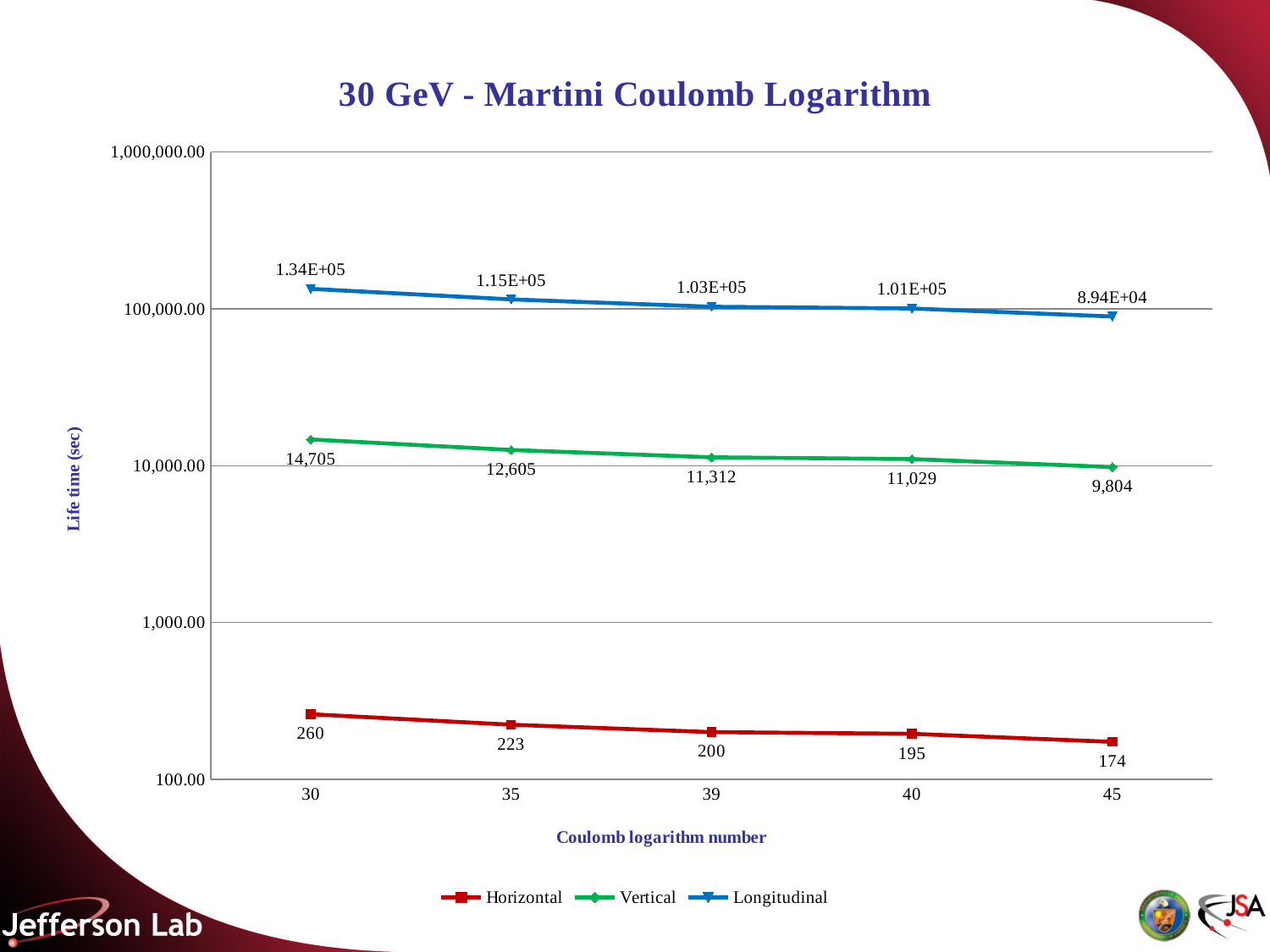
At which Coulomb logarithm number is the Horizontal life time lowest? 45 At which Coulomb logarithm number is the Vertical life time highest? 30 Which is larger, the Horizontal life time at 35 or at 40? 35 What is the Longitudinal life time at Coulomb logarithm number 45? 8.94E+04 What is the difference between the Vertical life time at 30 and at 35? 2,100 What is the Vertical life time at Coulomb logarithm number 45? 9,804 What is the Vertical life time at Coulomb logarithm number 39? 11,312 What is the difference between the Horizontal life time at 30 and at 45? 86 What is the Horizontal life time at Coulomb logarithm number 30? 260 How many series does the legend list? 3 How many Coulomb logarithm numbers are plotted on the x axis? 5 Does the Longitudinal life time rise or fall as the Coulomb logarithm number increases? fall